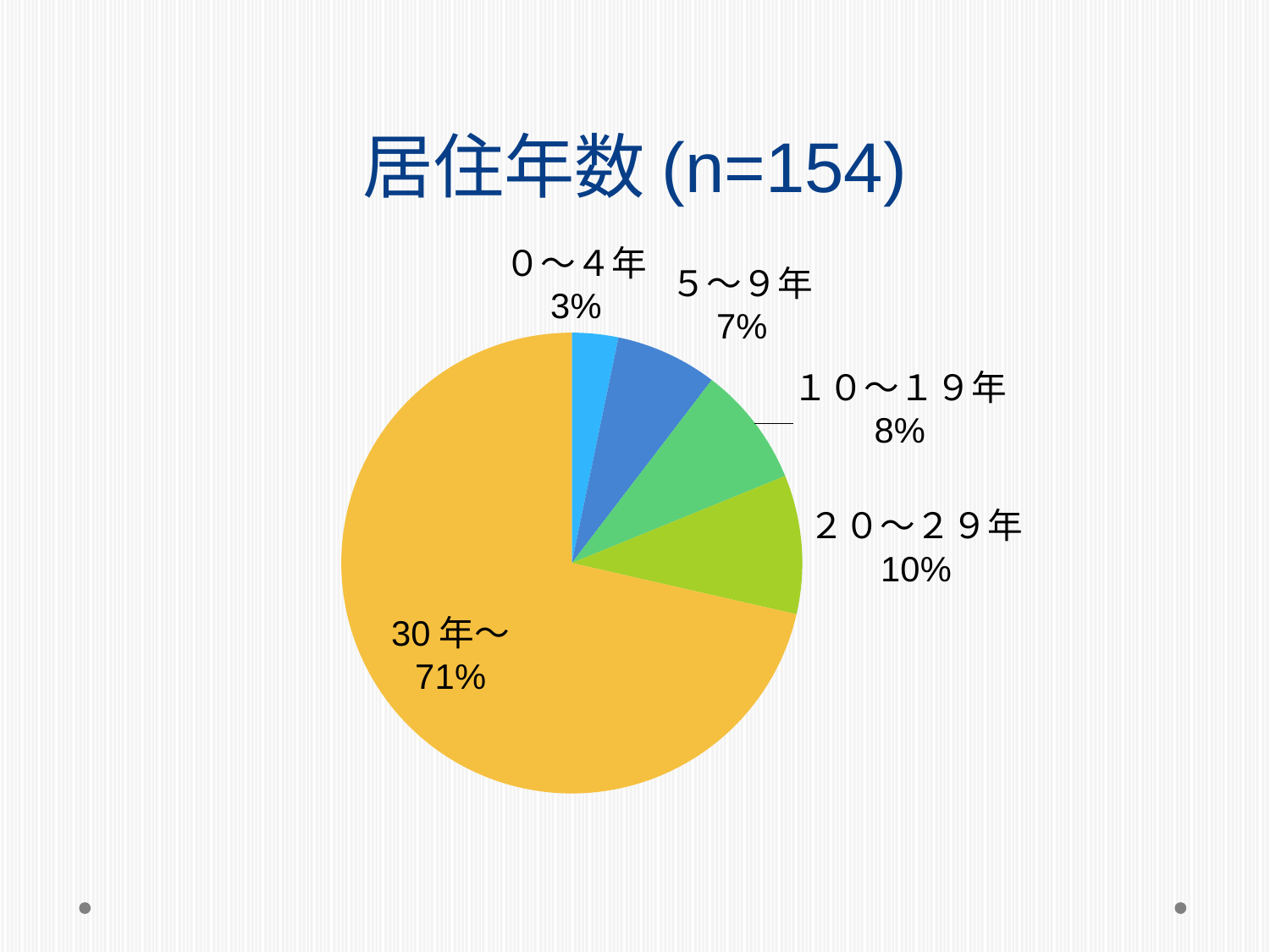
What percentage is shown for 0～4年? 3% What percentage is shown for 5～9年? 7% How many categories are shown in the pie chart? 5 What is the title of the chart? 居住年数 (n=154) What percentage is shown for 10～19年? 8% What percentage is shown for 30年～? 71% Which category has the smallest share of the pie? 0～4年 What kind of chart is shown on the slide? pie chart Which category has the largest share of the pie? 30年～ What is the difference in percentage points between 20～29年 and 5～9年? 3 What percentage is shown for 20～29年? 10% Which is larger, the share for 10～19年 or the share for 20～29年? 20～29年